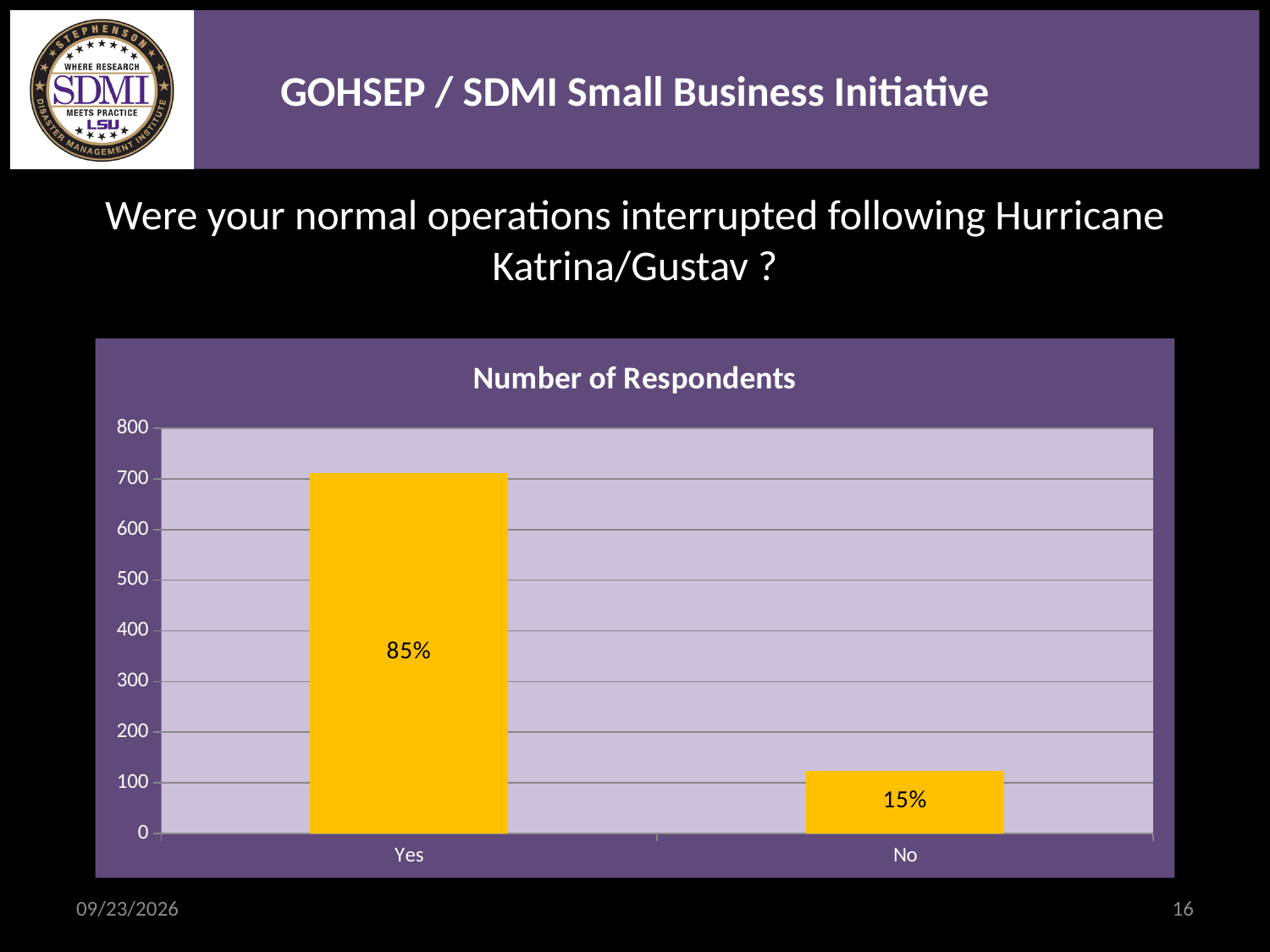
How many categories are shown on the x axis of the chart? 2 Is the number of respondents for No greater or less than 200? less What percentage label is shown on the Yes bar? 85% What is the title of the chart? Number of Respondents Which bar is taller, Yes or No? Yes What percentage label is shown on the No bar? 15% What is the highest value shown on the y axis of the chart? 800 What is the difference between the percentage labels on the Yes and No bars? 70% Which category has the lowest number of respondents? No Which category has the highest number of respondents? Yes What kind of chart is shown on the slide? bar chart Is the number of respondents for Yes greater or less than 600? greater